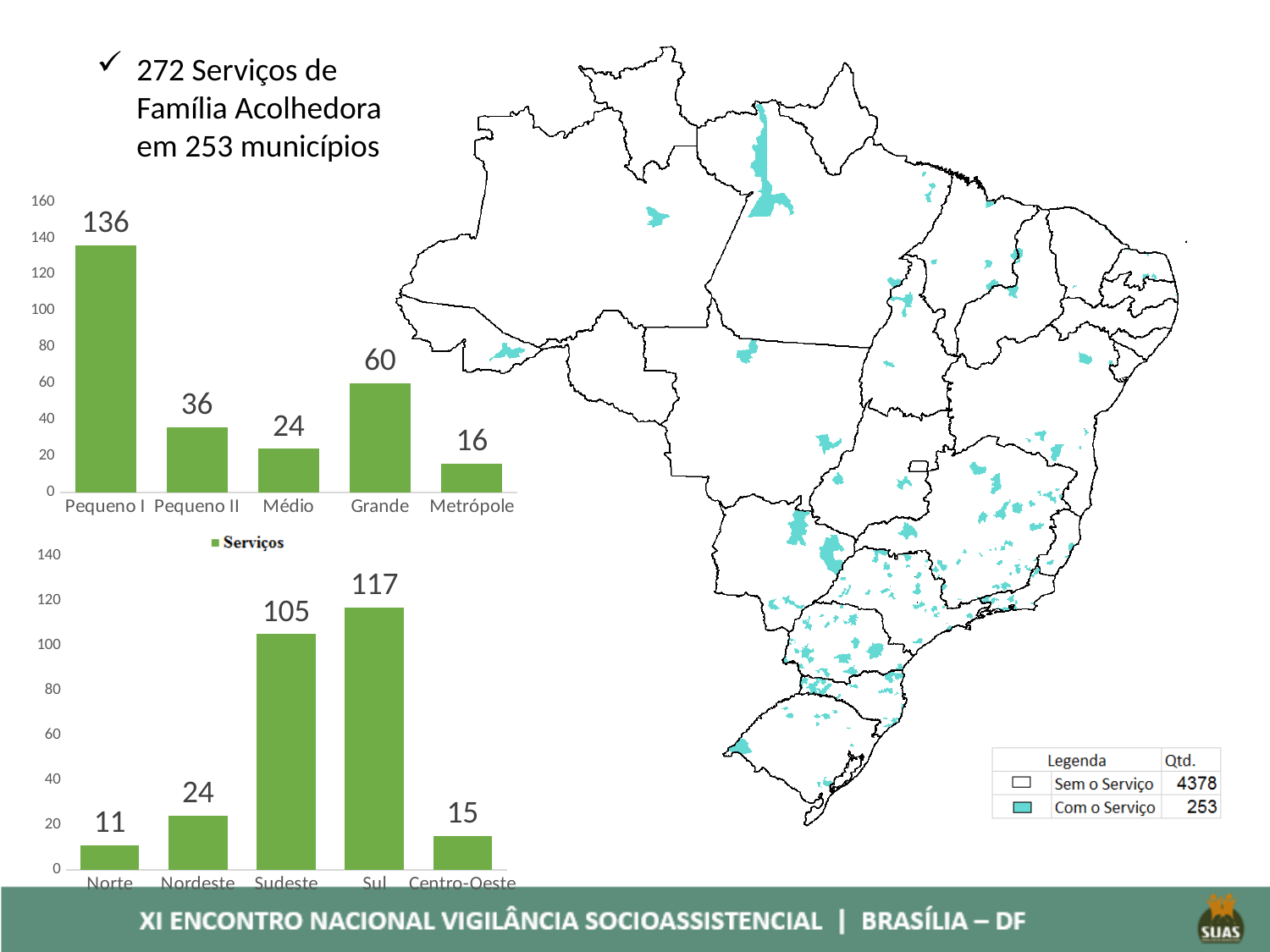
In the top bar chart (by municipality size), what series name does the legend show? Serviços In the bottom bar chart (by region), which is larger, Nordeste or Centro-Oeste? Nordeste In the top bar chart (by municipality size), which category has the lowest value? Metrópole In the top bar chart (by municipality size), which is larger, Pequeno II or Grande? Grande In the bottom bar chart (by region), which region has the highest value? Sul What type of chart is the bottom chart (by region)? Bar chart In the top bar chart (by municipality size), how many categories are shown? 5 In the bottom bar chart (by region), what is the difference between Sul and Sudeste? 12 In the bottom bar chart (by region), which region has the lowest value? Norte In the bottom bar chart (by region), what is the value for Sudeste? 105 In the top bar chart (by municipality size), what is the value for Pequeno I? 136 In the top bar chart (by municipality size), what is the difference between Grande and Médio? 36